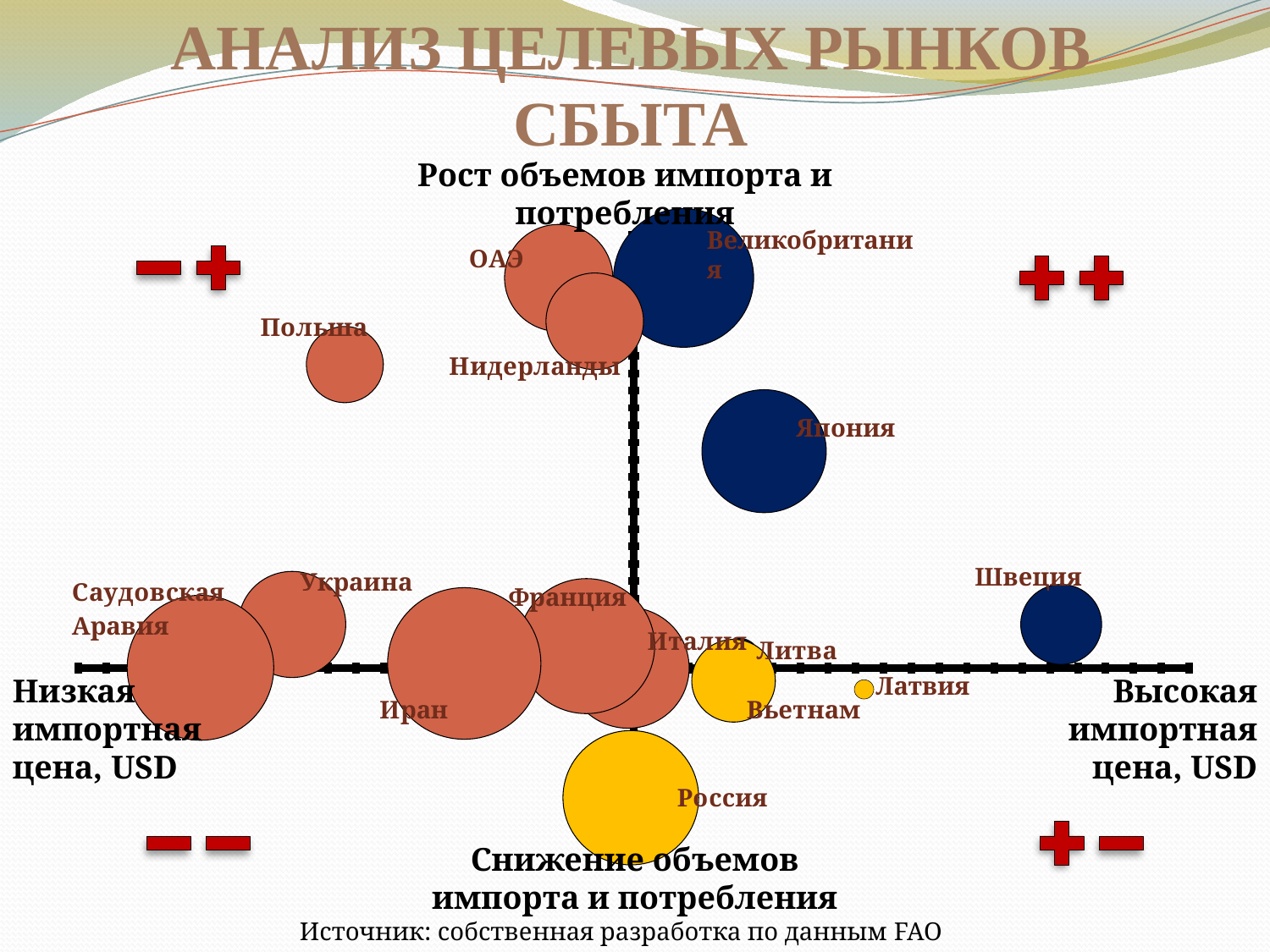
Which bubble is larger, Япония or Швеция? Япония Which bubble is positioned higher on the vertical axis, Япония or Швеция? Япония Which bubble is larger, Иран or Польша? Иран What does the label at the right end of the horizontal axis say? Высокая импортная цена, USD What is the title of the slide containing the chart? АНАЛИЗ ЦЕЛЕВЫХ РЫНКОВ СБЫТА Which country's bubble is the largest on the chart? Иран Which country's bubble is positioned lowest on the chart (furthest toward 'Снижение объемов импорта и потребления')? Россия Which country's bubble is positioned furthest to the right (highest import price)? Швеция Which country's bubble is the smallest on the chart? Латвия What kind of chart is shown on the slide? bubble chart